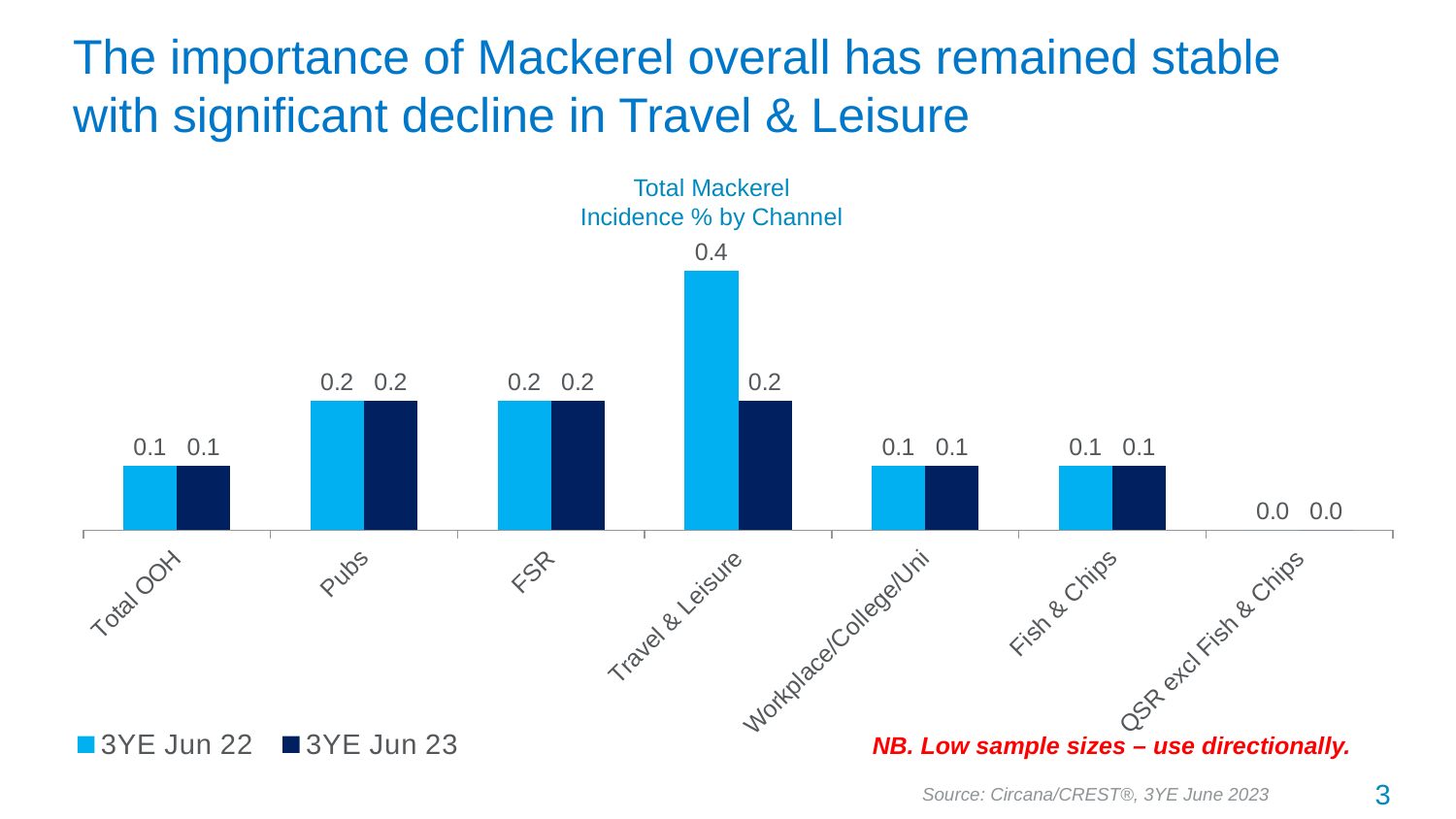
Which channel has the highest value in the 3YE Jun 22 series? Travel & Leisure What is the value for Pubs in the 3YE Jun 23 series? 0.2 What kind of chart is shown on the slide? Bar chart How many channels are shown on the x axis? 7 Which channel has the lowest value in the 3YE Jun 23 series? QSR excl Fish & Chips What is the value for Total OOH in the 3YE Jun 22 series? 0.1 What is the difference between the 3YE Jun 22 and 3YE Jun 23 values for Travel & Leisure? 0.2 How many series does the legend list? 2 Which is larger for Travel & Leisure: the 3YE Jun 22 value or the 3YE Jun 23 value? 3YE Jun 22 What is the title of the chart? Total Mackerel Incidence % by Channel What is the value for Travel & Leisure in the 3YE Jun 23 series? 0.2 What is the value for Travel & Leisure in the 3YE Jun 22 series? 0.4